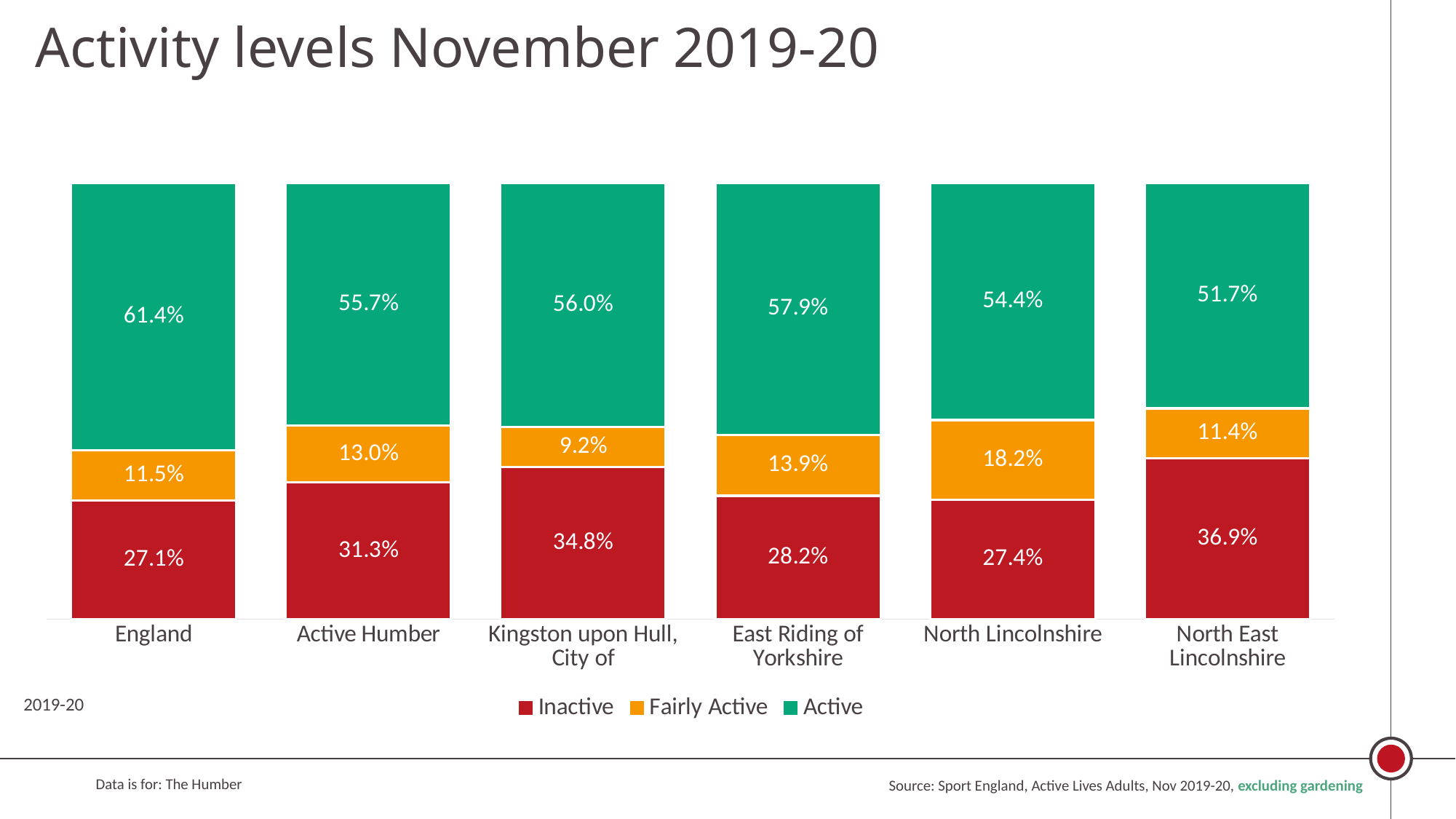
What is the Inactive value for North East Lincolnshire? 36.9% What is the Fairly Active value for North Lincolnshire? 18.2% What kind of chart is shown? Stacked bar chart What is the difference between the Active values for England and Active Humber? 5.7% What is the title of the chart? Activity levels November 2019-20 Which category has the highest Inactive value? North East Lincolnshire How many series does the legend list? 3 Which is larger, the Inactive value for Kingston upon Hull, City of or for East Riding of Yorkshire? Kingston upon Hull, City of How many categories are shown on the x axis? 6 Which category has the lowest Fairly Active value? Kingston upon Hull, City of What is the Active value for England? 61.4% Which category has the lowest Active value? North East Lincolnshire